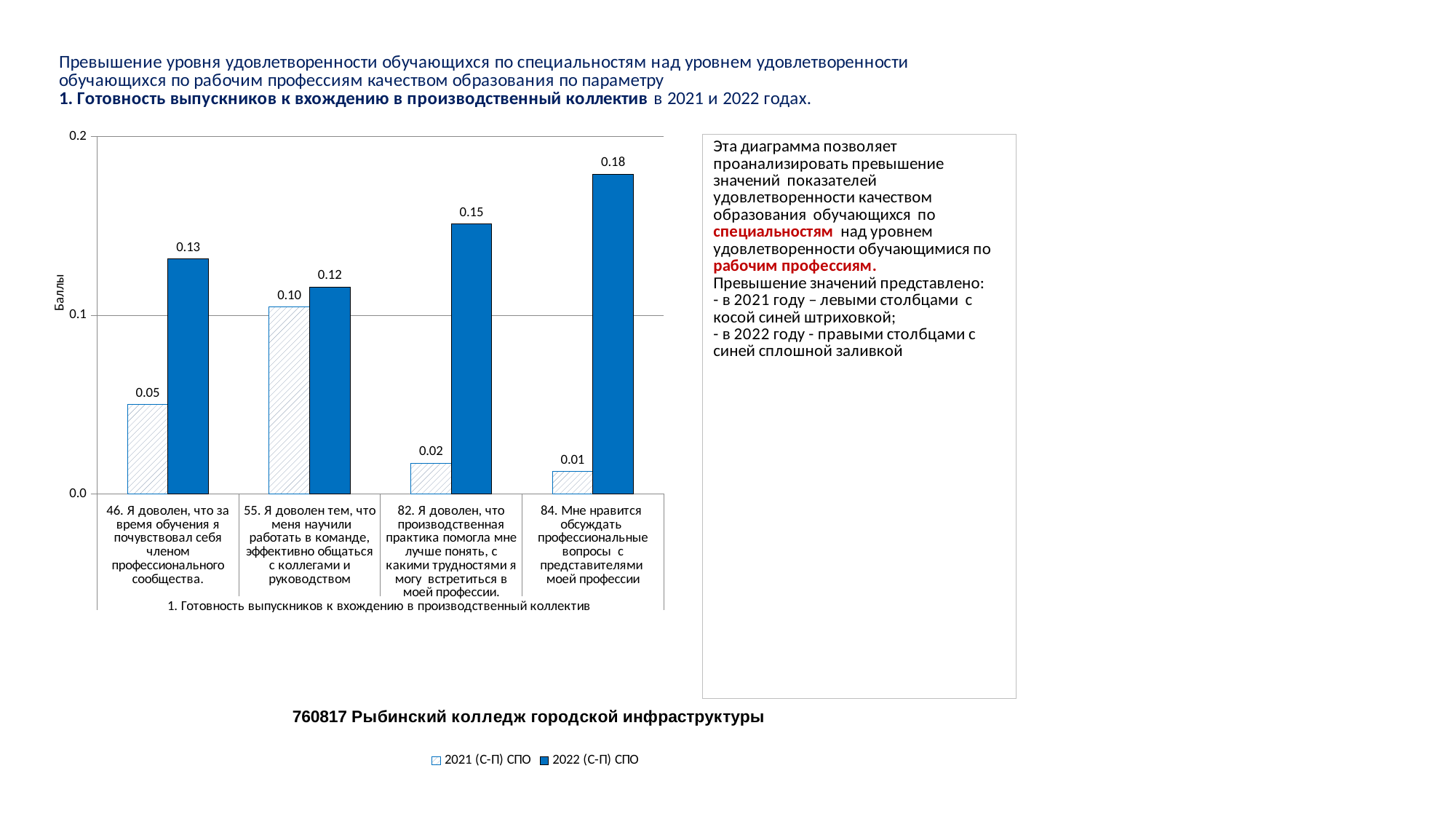
What is the difference between the 2022 and 2021 values for category 46 (Я доволен, что за время обучения я почувствовал себя членом профессионального сообщества)? 0.08 What is the 2021 (С-П) СПО value for category 55 (Я доволен тем, что меня научили работать в команде)? 0.10 Is the 2022 (С-П) СПО value for category 82 greater or less than 0.1? greater What type of chart is shown on the slide? bar chart How many categories are shown on the x axis of the chart? 4 Which is larger for category 55: the 2021 (С-П) СПО value or the 2022 (С-П) СПО value? 2022 (С-П) СПО Which category has the highest 2022 (С-П) СПО value? 84. Мне нравится обсуждать профессиональные вопросы с представителями моей профессии What is the 2022 (С-П) СПО value for category 84 (Мне нравится обсуждать профессиональные вопросы с представителями моей профессии)? 0.18 How many series does the chart legend list? 2 What is the label of the vertical axis of the chart? Баллы What is the 2021 (С-П) СПО value for category 82 (Я доволен, что производственная практика помогла мне лучше понять...)? 0.02 Which category has the lowest 2021 (С-П) СПО value? 84. Мне нравится обсуждать профессиональные вопросы с представителями моей профессии